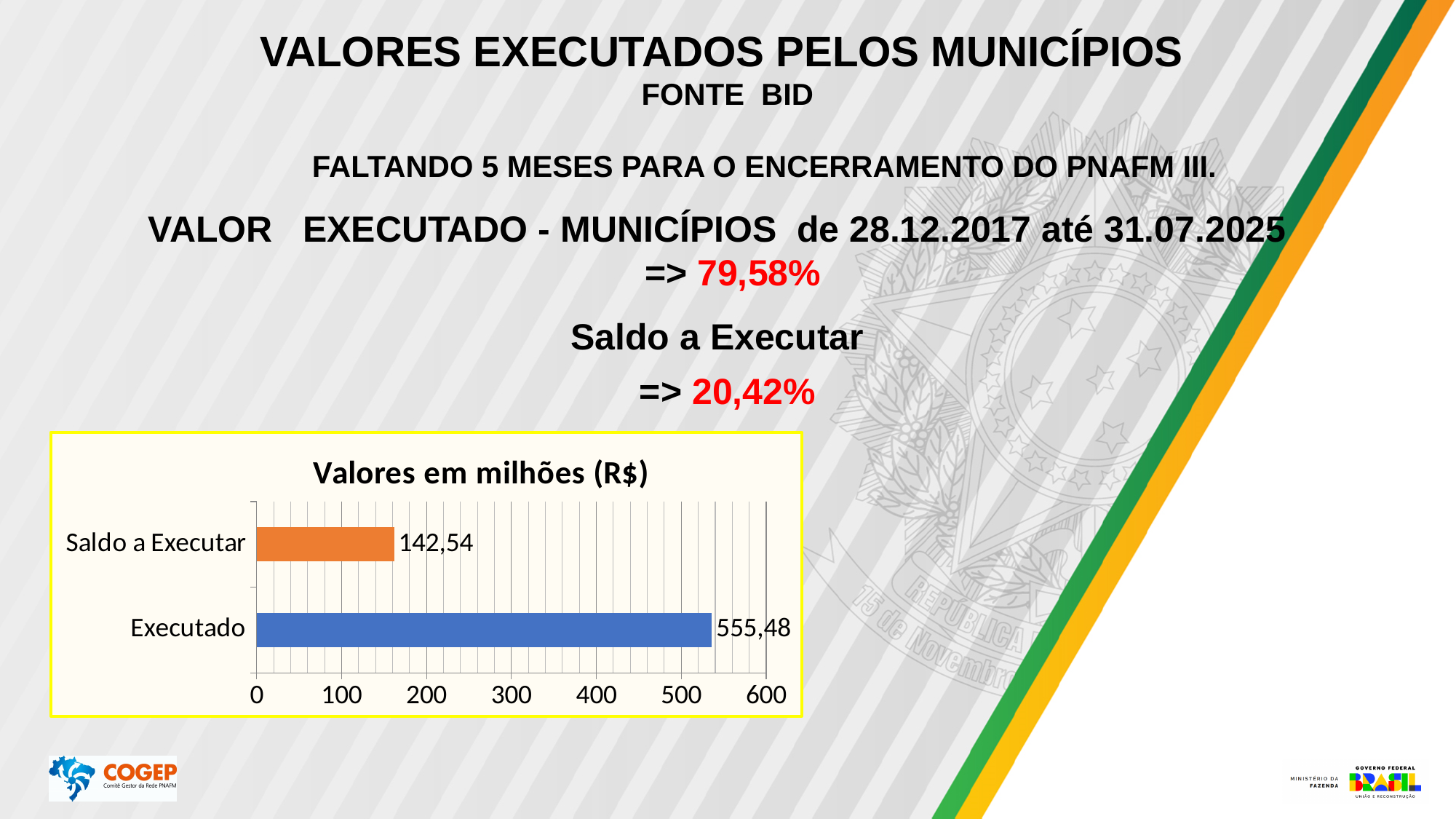
What kind of chart is shown on the slide? bar chart Which is larger, the value for Executado or the value for Saldo a Executar? Executado What colour is the bar for Saldo a Executar? orange Which category has the lowest value in the chart? Saldo a Executar Is the value for Executado greater or less than 500? greater How many categories are shown in the chart? 2 Is the value for Saldo a Executar greater or less than 200? less Which category has the highest value in the chart? Executado What is the difference between the values for Executado and Saldo a Executar? 412,94 What is the value for Saldo a Executar in the chart? 142,54 What is the title of the chart? Valores em milhões (R$) What is the value for Executado in the chart? 555,48